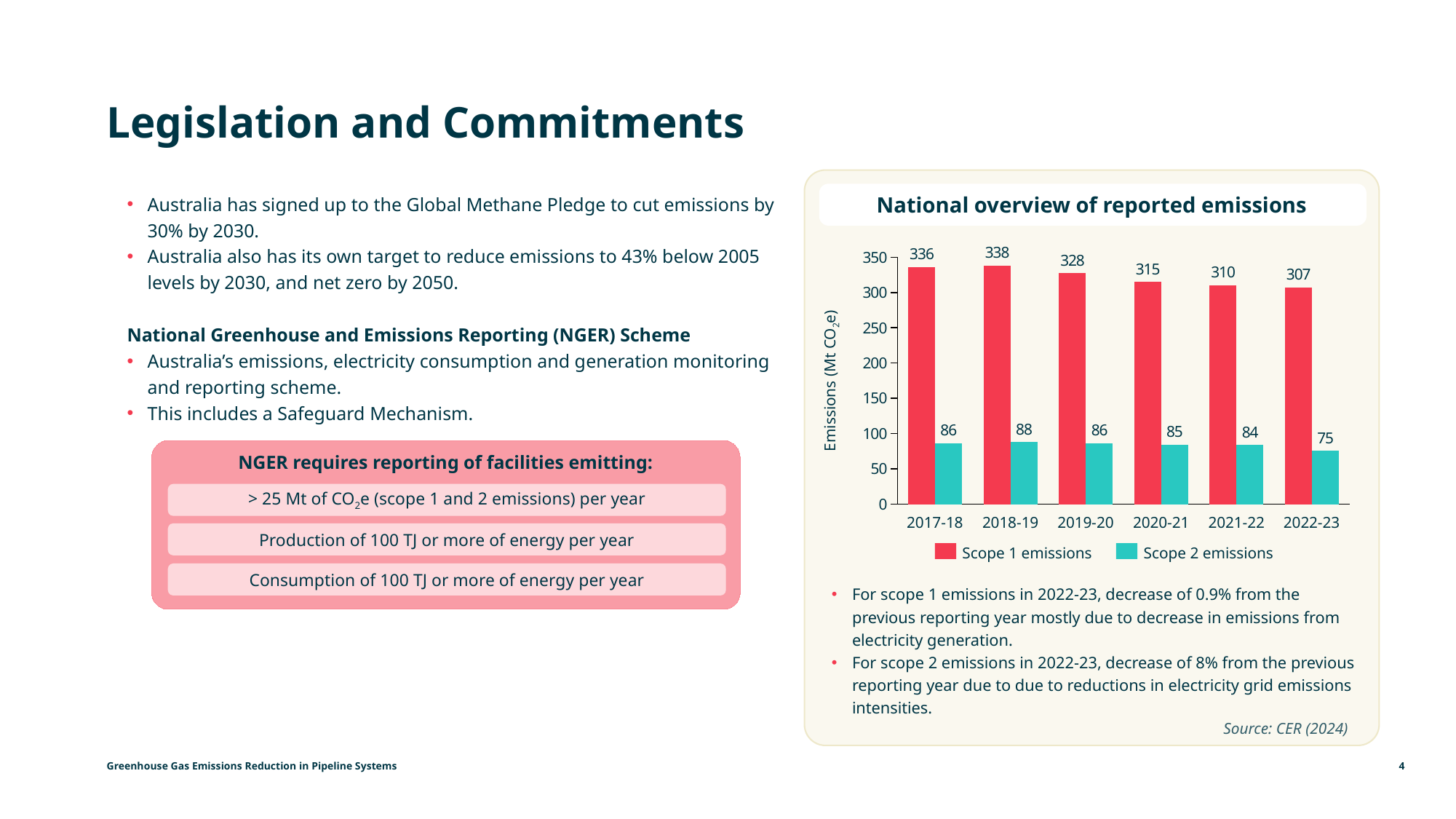
How many reporting years are shown on the x axis? 6 What is the title of the chart? National overview of reported emissions Do Scope 1 emissions rise or fall from 2018-19 to 2022-23? fall What is the Scope 2 emissions value for 2022-23? 75 Which year has the highest Scope 1 emissions? 2018-19 How many series does the legend list? 2 Which year has the lowest Scope 2 emissions? 2022-23 Which is larger, Scope 2 emissions in 2018-19 or in 2020-21? 2018-19 What is the Scope 1 emissions value for 2018-19? 338 What is the difference between Scope 1 emissions in 2017-18 and 2022-23? 29 What kind of chart is shown on the slide? bar chart Is the Scope 1 emissions value for 2020-21 greater or less than 300? greater